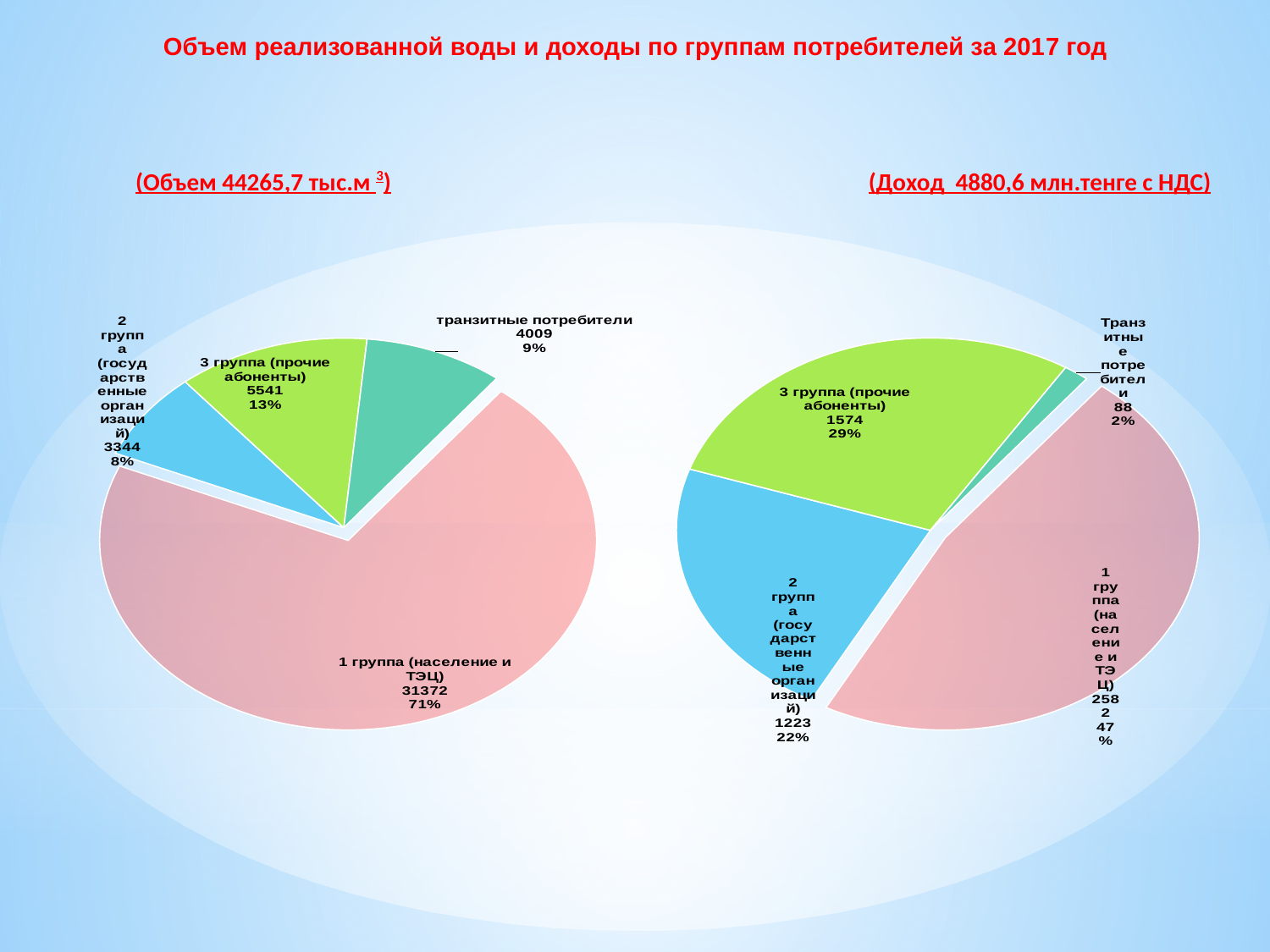
What is the title of the slide? Объем реализованной воды и доходы по группам потребителей за 2017 год In the left pie chart (volume), what is the value for 1 группа (население и ТЭЦ)? 31372 In the left pie chart (volume), what is the value for транзитные потребители? 4009 In the right pie chart (income), which is larger: 2 группа (государственные организаций) or 3 группа (прочие абоненты)? 3 группа (прочие абоненты) In the right pie chart (income), what is the value for 3 группа (прочие абоненты)? 1574 In the right pie chart (income), what share does 1 группа (население и ТЭЦ) have? 47% In the right pie chart (income), which group has the smallest slice? Транзитные потребители In the left pie chart (volume), what share does 3 группа (прочие абоненты) have? 13% In the left pie chart (volume), what is the difference between 3 группа (прочие абоненты) and 2 группа (государственные организаций)? 2197 How many slices does the right pie chart (income) have? 4 In the left pie chart (volume), which group has the smallest slice? 2 группа (государственные организаций) What type of charts are shown on the slide? Pie charts